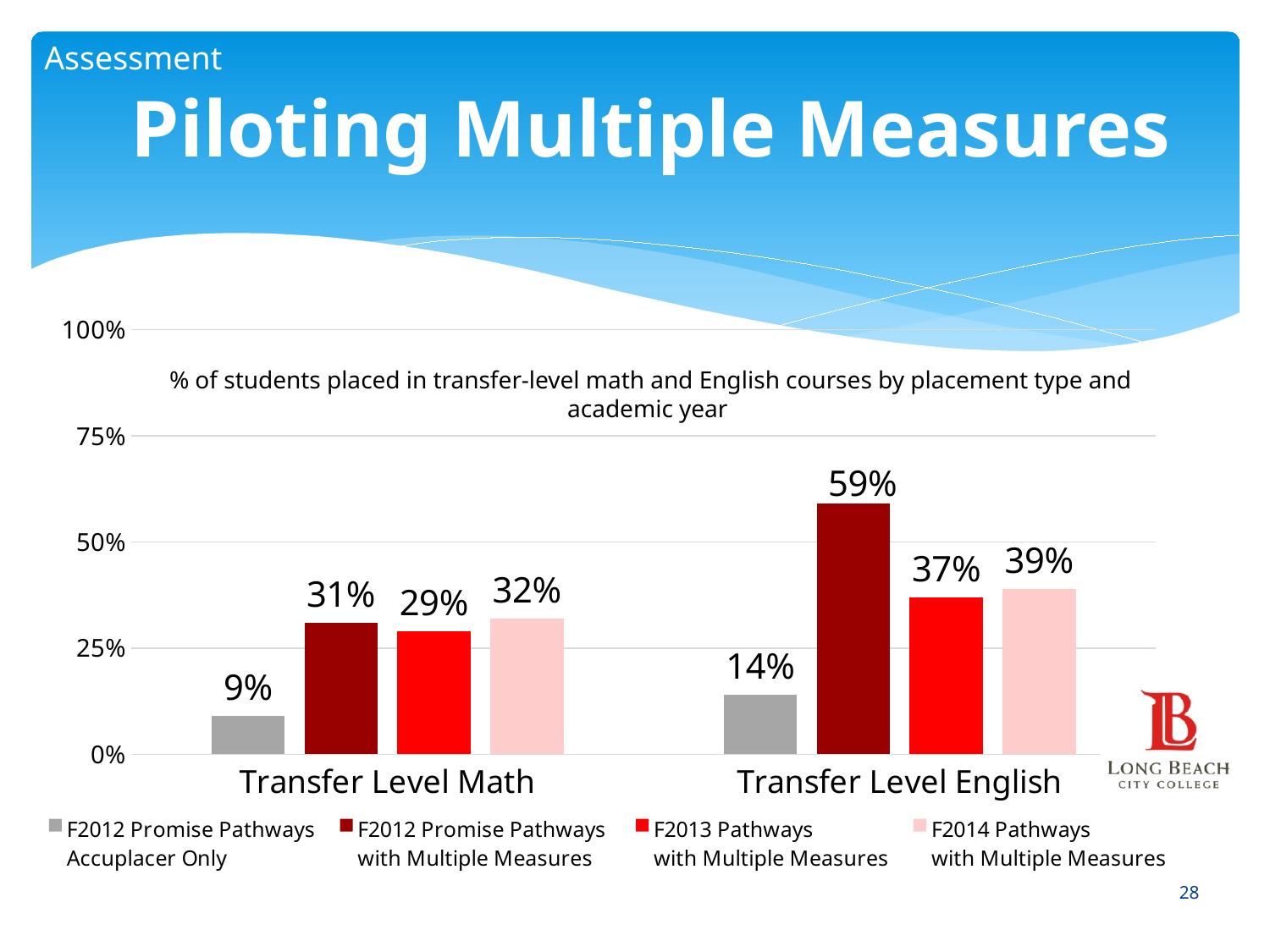
What is the difference between the F2014 Pathways with Multiple Measures value and the F2013 Pathways with Multiple Measures value for Transfer Level Math? 3% What is the value for F2013 Pathways with Multiple Measures in Transfer Level English? 37% What is the difference between the F2012 Promise Pathways with Multiple Measures value and the F2012 Promise Pathways Accuplacer Only value for Transfer Level English? 45% What is the value for F2014 Pathways with Multiple Measures in Transfer Level Math? 32% How many series does the legend list? 4 What is the title of the chart? % of students placed in transfer-level math and English courses by placement type and academic year Which is larger: the F2013 Pathways with Multiple Measures value for Transfer Level Math or for Transfer Level English? Transfer Level English Which series has the lowest value for Transfer Level Math? F2012 Promise Pathways Accuplacer Only What kind of chart is shown on the slide? Bar chart What percentage of students were placed in Transfer Level English under F2012 Promise Pathways with Multiple Measures? 59% What percentage of students were placed in Transfer Level Math under F2012 Promise Pathways Accuplacer Only? 9% Which series has the highest value for Transfer Level English? F2012 Promise Pathways with Multiple Measures